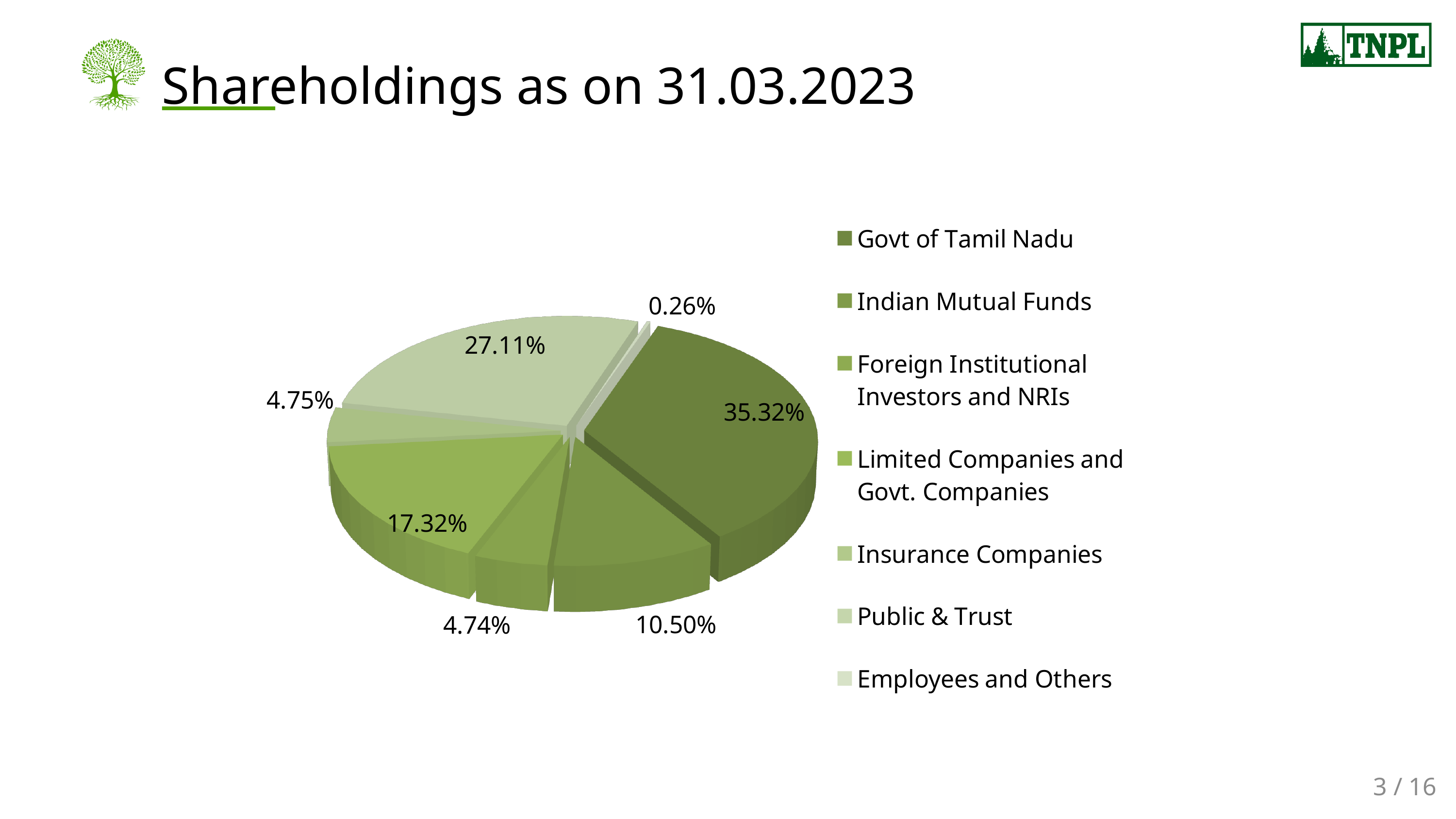
What is the title of the slide containing the pie chart? Shareholdings as on 31.03.2023 Which shareholder category has the smallest slice of the pie? Employees and Others Which is larger, the share of Public & Trust or the share of Limited Companies and Govt. Companies? Public & Trust What is the difference between the shares of Govt of Tamil Nadu and Public & Trust? 8.21% What is the value shown for Limited Companies and Govt. Companies? 17.32% What is the value shown for Indian Mutual Funds? 10.50% What kind of chart is shown on the slide? Pie chart How many shareholder categories does the pie chart show? 7 What share of the pie does Public & Trust hold? 27.11% What share of the pie does Govt of Tamil Nadu hold? 35.32% What is the value shown for Employees and Others? 0.26% Which shareholder category has the largest slice of the pie? Govt of Tamil Nadu